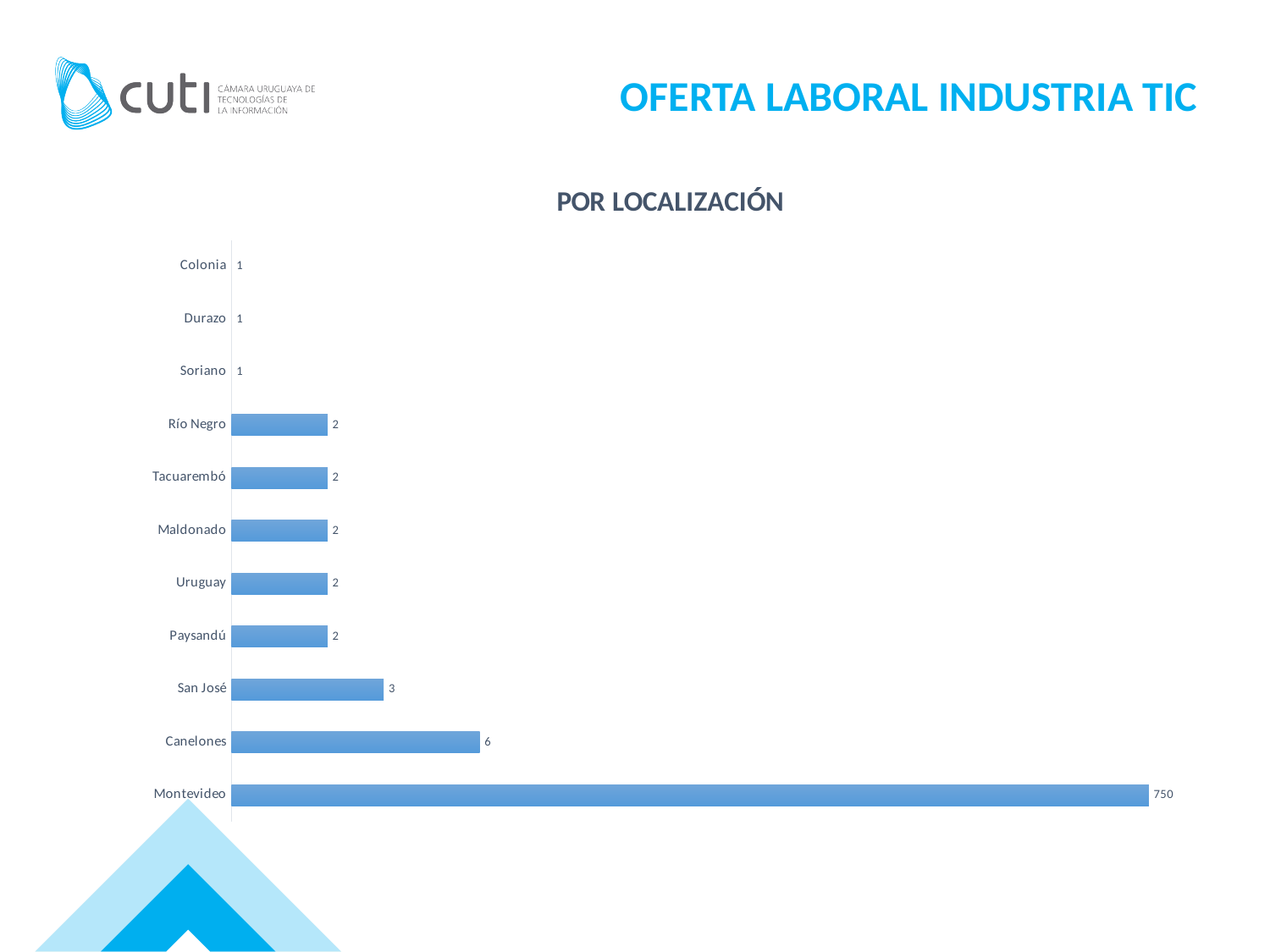
How many locations are shown in the chart? 11 Which location has the highest value? Montevideo Which is larger, the value for San José or the value for Paysandú? San José What is the value for San José? 3 What is the value for Colonia? 1 What is the difference between the values for Canelones and San José? 3 What is the title of the chart? POR LOCALIZACIÓN What is the value for Canelones? 6 What is the value for Montevideo? 750 What is the difference between the values for Montevideo and Canelones? 744 What kind of chart is shown on the slide? Bar chart What is the value for Maldonado? 2